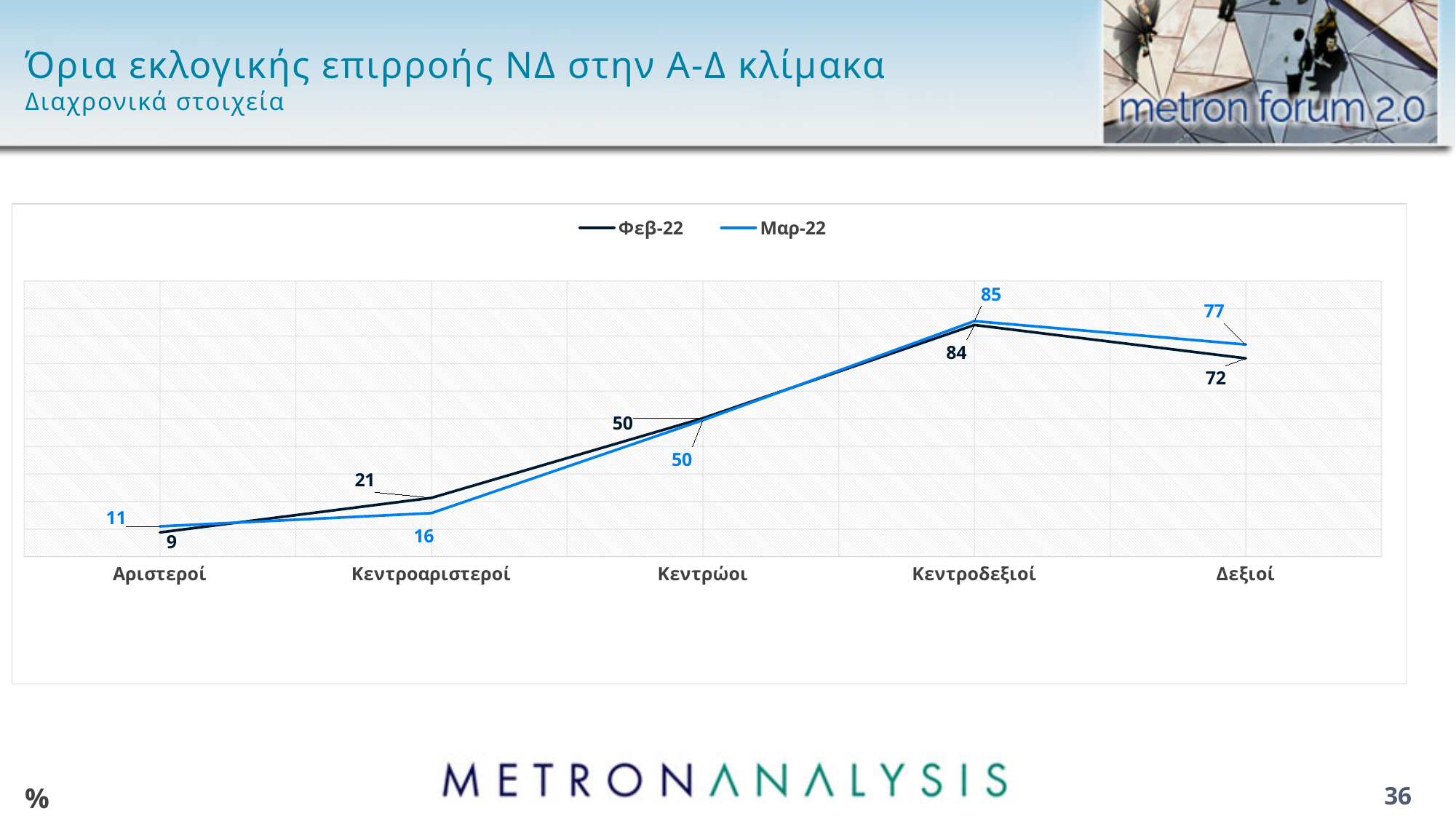
What is the Φεβ-22 value for Κεντροδεξιοί? 84 How many categories are shown on the x axis? 5 Which category has the highest Μαρ-22 value? Κεντροδεξιοί What is the Φεβ-22 value for Αριστεροί? 9 What kind of chart is shown on the slide? Line chart Which colour is used for the Μαρ-22 series? Blue What is the Μαρ-22 value for Δεξιοί? 77 What is the Μαρ-22 value for Κεντροαριστεροί? 16 How many series does the legend list? 2 What is the difference between the Μαρ-22 and Φεβ-22 values for Δεξιοί? 5 Which is larger for Κεντροαριστεροί: the Φεβ-22 value or the Μαρ-22 value? Φεβ-22 Which category has the lowest Φεβ-22 value? Αριστεροί